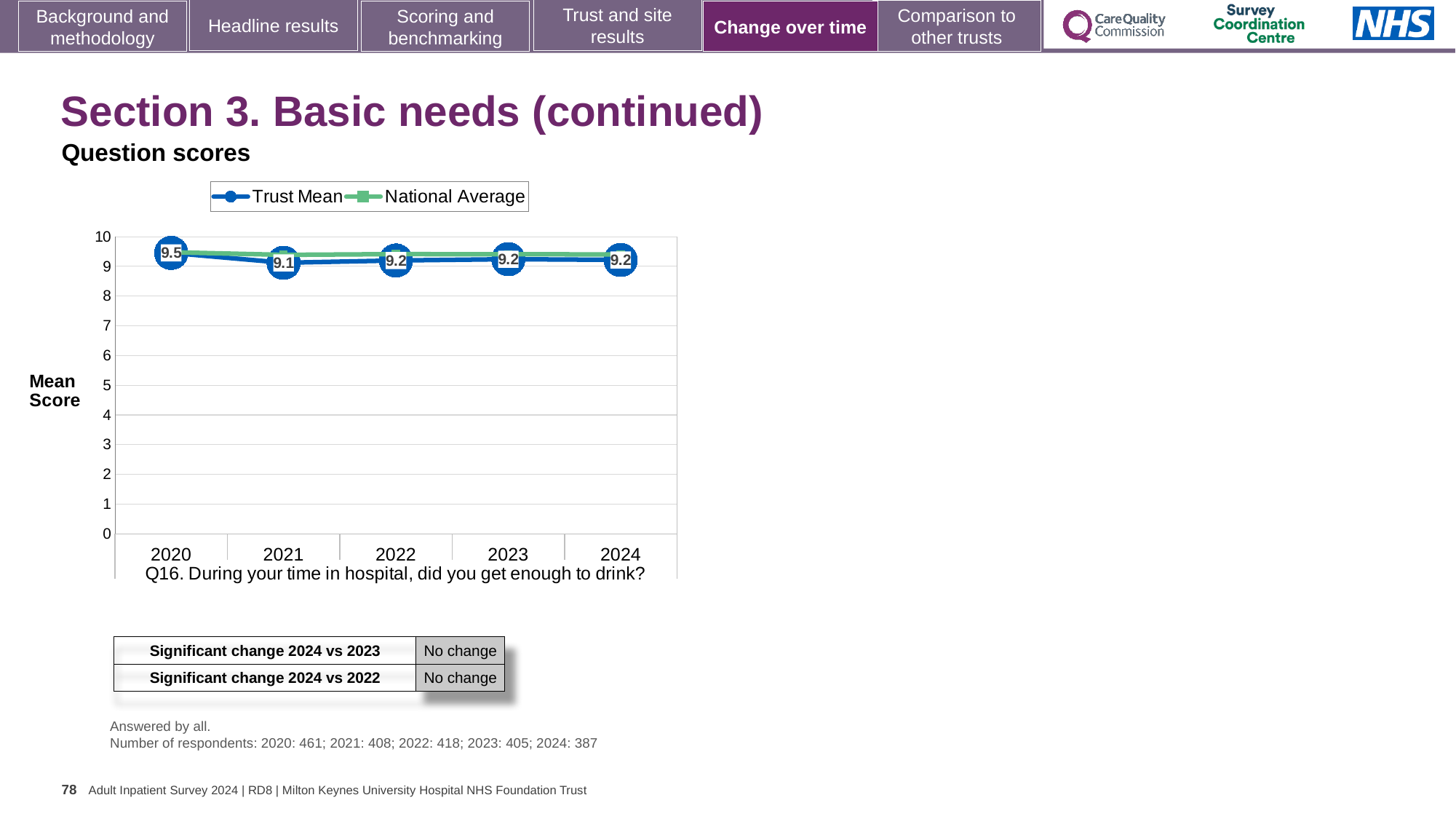
What is the Trust Mean score for 2024? 9.2 Which is larger, the Trust Mean score for 2020 or for 2024? 2020 What is the difference between the Trust Mean scores for 2020 and 2021? 0.4 In which year is the Trust Mean score lowest? 2021 In which year is the Trust Mean score highest? 2020 Which question does the chart show scores for? Q16. During your time in hospital, did you get enough to drink? Is the National Average value for 2022 greater or less than 8? greater What is the Trust Mean score for 2021? 9.1 What is the Trust Mean score for 2020? 9.5 How many series does the legend list? 2 How many years are plotted on the x axis? 5 What kind of chart is shown on the slide? Line chart